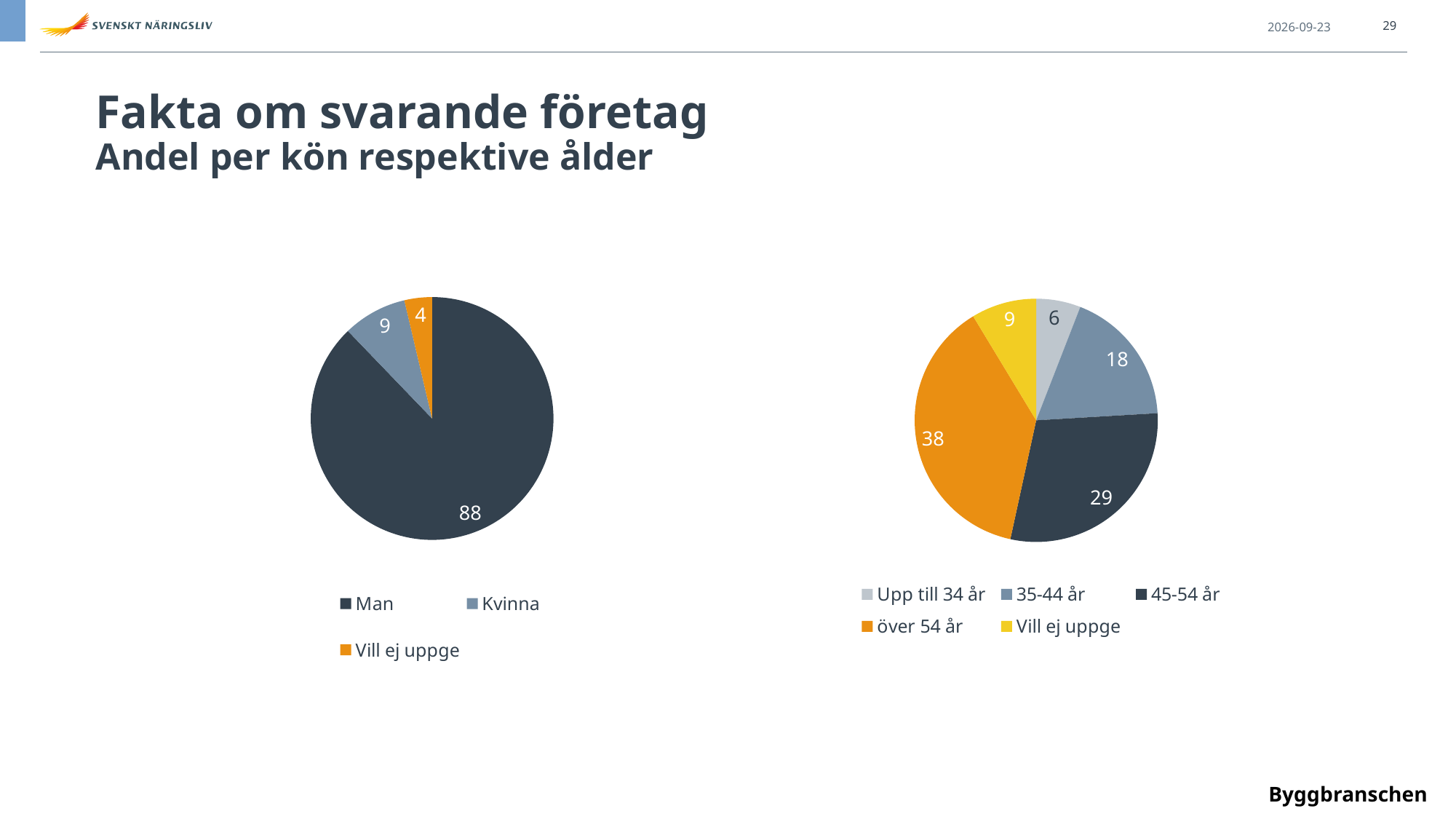
In the left pie chart (gender), what is the difference between Man and Kvinna? 79 In the left pie chart (gender), what is the value for Man? 88 In the left pie chart (gender), what is the value for Kvinna? 9 In the right pie chart (age), what is the value for över 54 år? 38 In the right pie chart (age), which is larger: 45-54 år or 35-44 år? 45-54 år How many categories does the legend of the right pie chart (age) list? 5 What kind of chart is the left chart (gender)? Pie chart In the right pie chart (age), which category has the smallest slice? Upp till 34 år In the left pie chart (gender), which category has the largest slice? Man In the left pie chart (gender), what is the value for Vill ej uppge? 4 In the right pie chart (age), what is the difference between över 54 år and 45-54 år? 9 In the right pie chart (age), what is the value for 35-44 år? 18